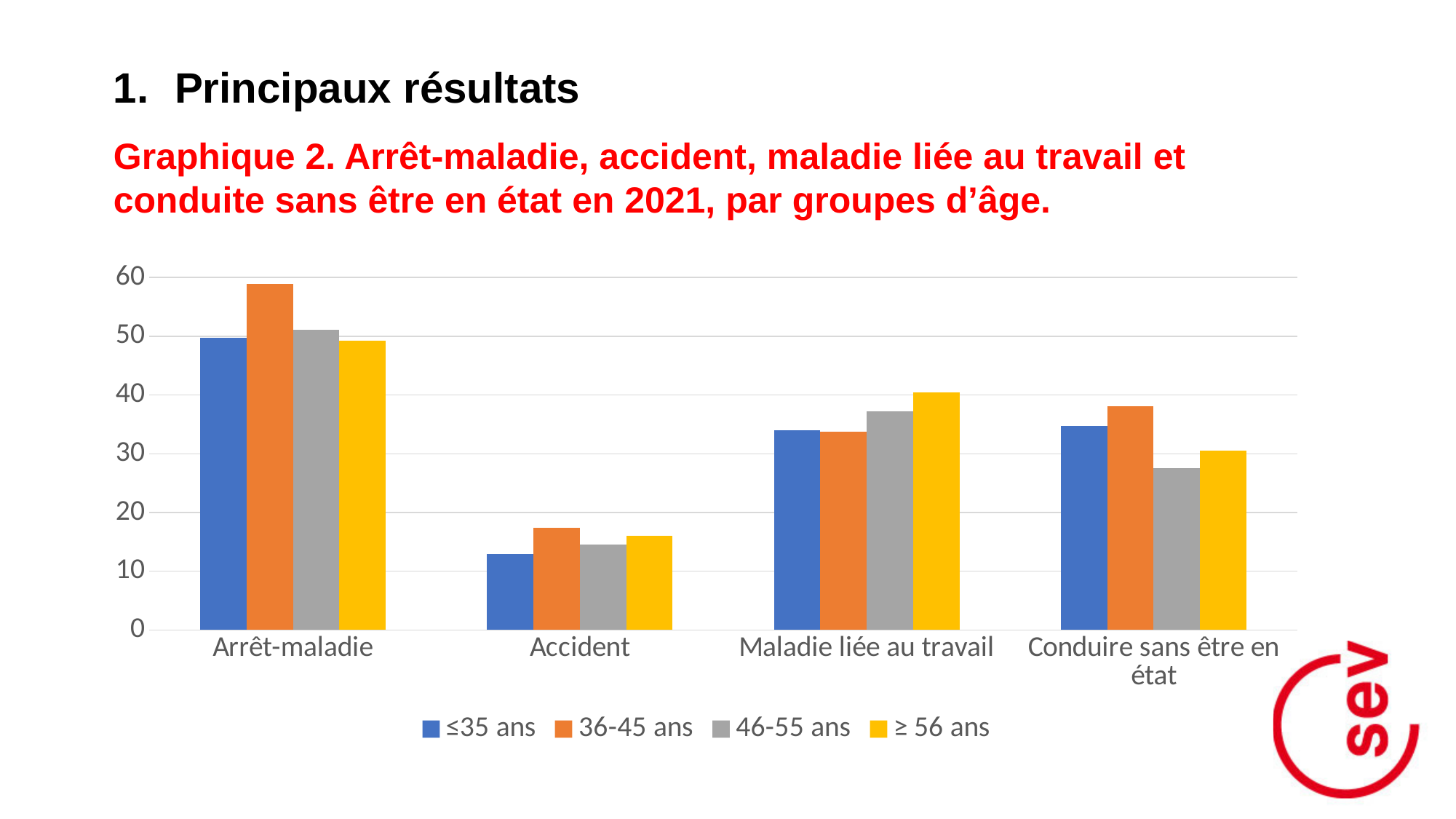
Within the Arrêt-maladie category, which age group has the highest bar? 36-45 ans Is the value for 46-55 ans in Conduire sans être en état greater or less than 30? less Within the Maladie liée au travail category, which age group has the highest bar? ≥ 56 ans In Conduire sans être en état, which is larger: the value for 36-45 ans or for 46-55 ans? 36-45 ans Which category has the tallest bars overall? Arrêt-maladie Within the Conduire sans être en état category, which age group has the lowest bar? 46-55 ans How many series does the legend list? 4 What kind of chart is shown on the slide? bar chart Is the value for 36-45 ans in Arrêt-maladie greater or less than 50? greater What colour represents the ≥ 56 ans series? yellow Is the value for ≤35 ans in Accident greater or less than 20? less How many categories are shown on the x axis? 4